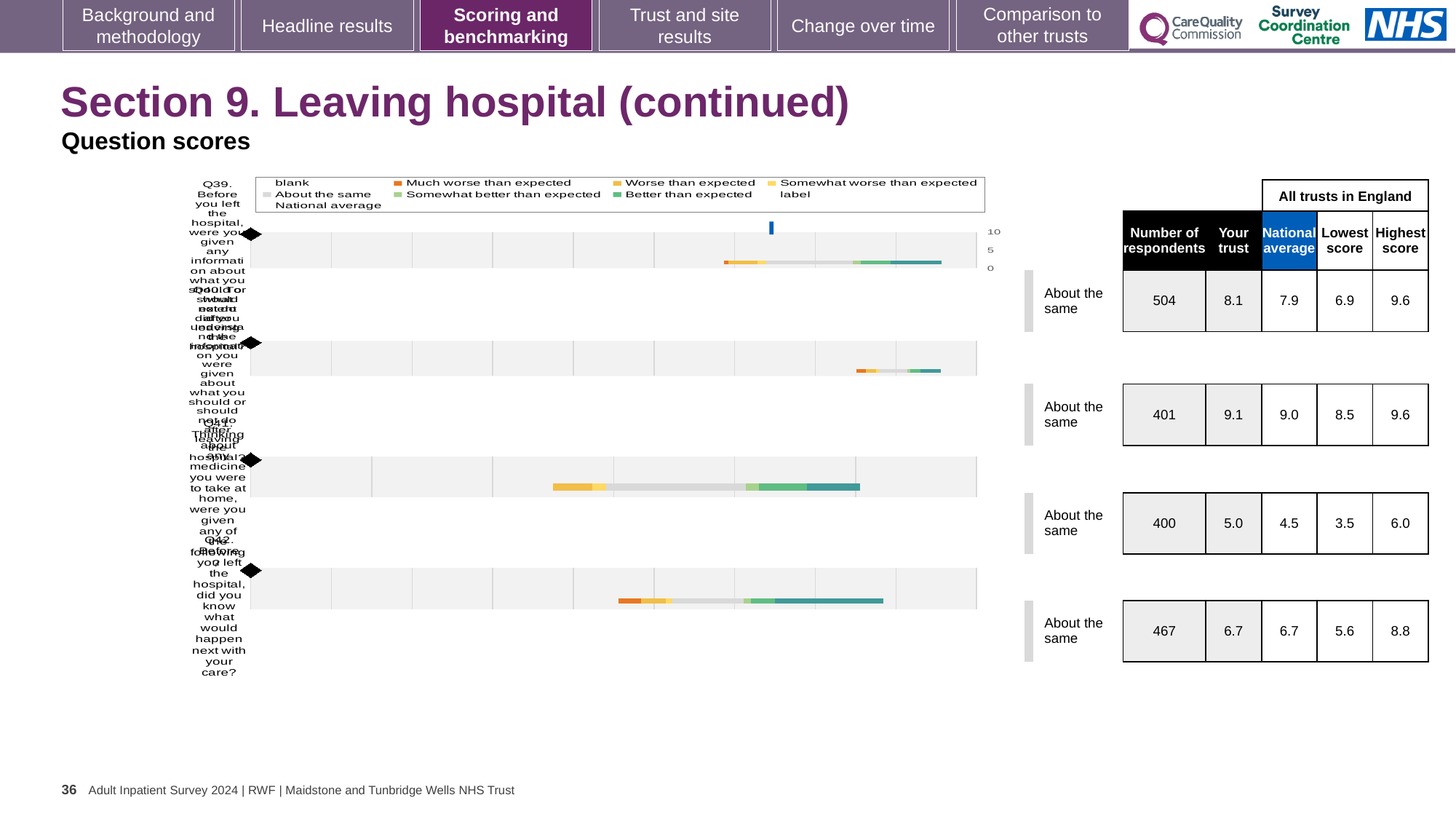
What is the national average for the first question row (Q39)? 7.9 Which question row has the highest 'Your trust' score? the second row (9.1) What benchmark category is shown next to every question row in the chart? About the same What is the number of respondents for the second question row? 401 What kind of chart is used to show the question scores on this slide? bar chart What is the highest score across all trusts in England for the third question row? 6.0 What is the lowest score across all trusts in England for the last question row (Q42)? 5.6 What is the 'Your trust' score for the third question row? 5.0 What is the 'Your trust' score for the first question row (Q39)? 8.1 What is the difference between the 'Your trust' score and the national average for the third question row? 0.5 In the chart legend, which entry is shown in orange? Much worse than expected How many question rows (bars) are plotted in the benchmarking chart? 4